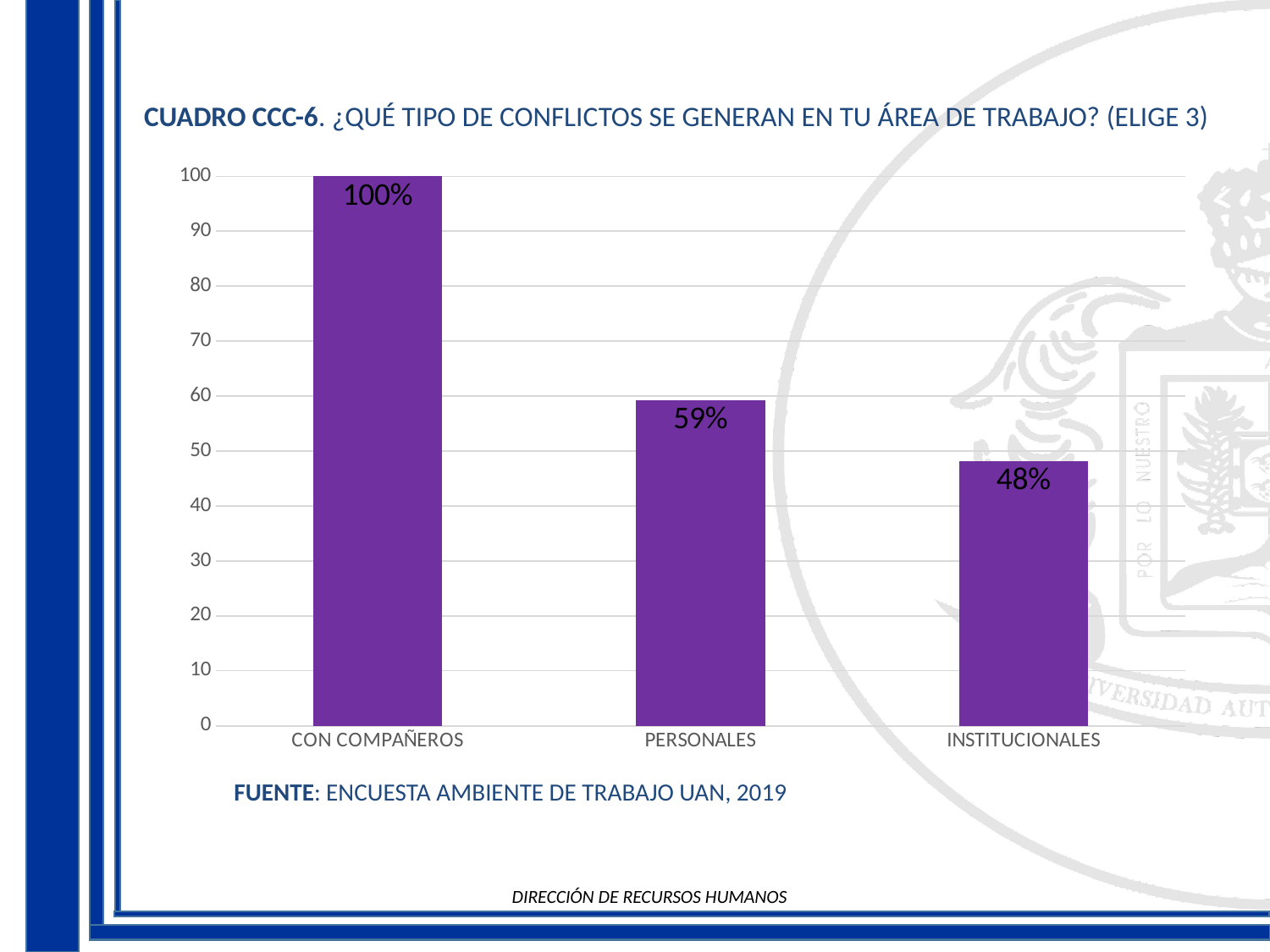
Which category has the highest value? CON COMPAÑEROS What is the value for INSTITUCIONALES? 48% What is the value for CON COMPAÑEROS? 100% How many categories are shown in the chart? 3 Is the value for INSTITUCIONALES greater or less than 50? less What is the difference between the values for CON COMPAÑEROS and PERSONALES? 41% What is the difference between the values for PERSONALES and INSTITUCIONALES? 11% Which is larger, the value for PERSONALES or the value for INSTITUCIONALES? PERSONALES What is the source cited below the chart? ENCUESTA AMBIENTE DE TRABAJO UAN, 2019 What is the value for PERSONALES? 59% Which category has the lowest value? INSTITUCIONALES What kind of chart is shown on the slide? bar chart